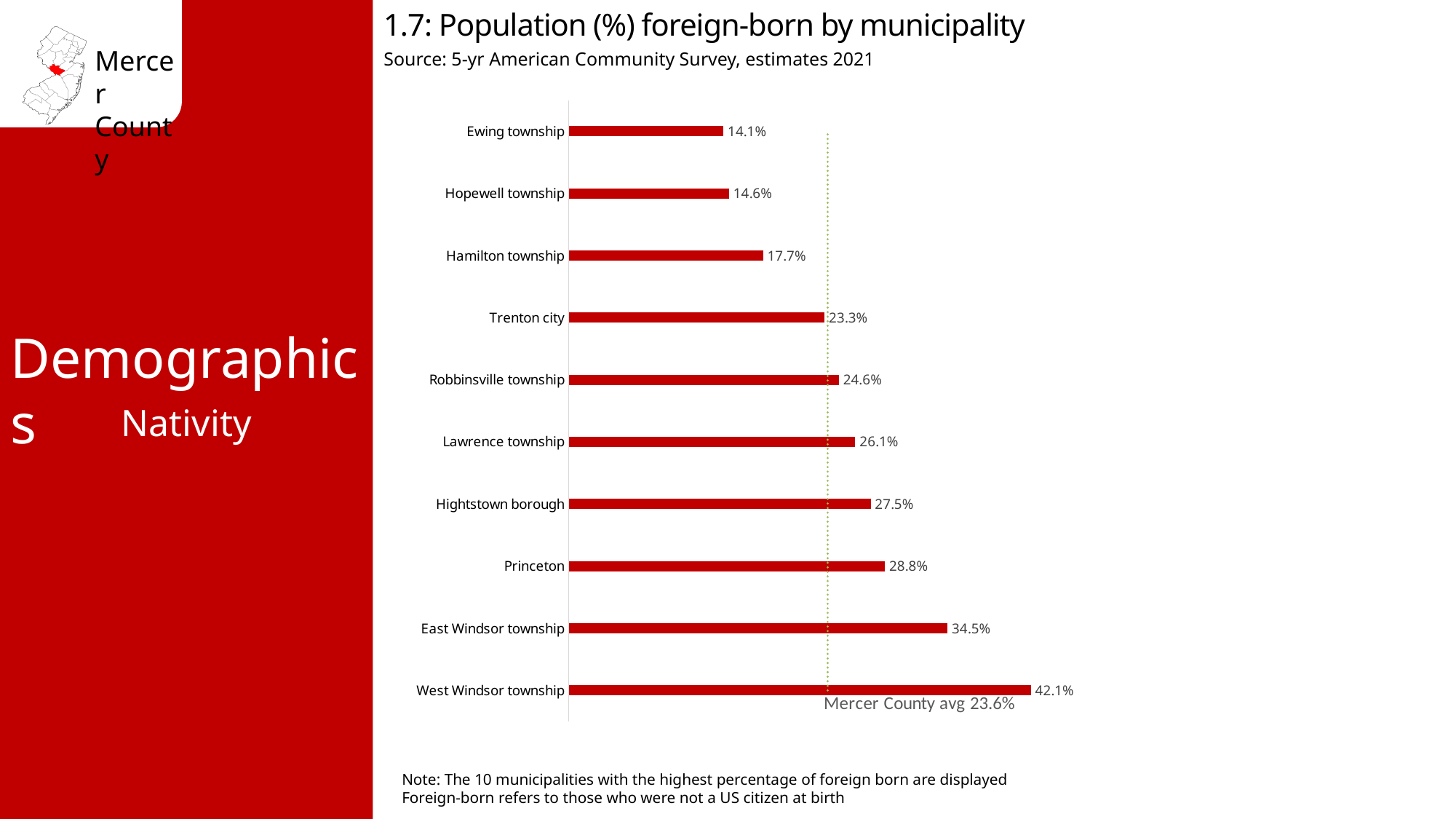
How many municipalities are shown in the chart? 10 What type of chart is shown on the slide? Bar chart Which has a higher foreign-born percentage, Lawrence township or Robbinsville township? Lawrence township What is the foreign-born population percentage for West Windsor township? 42.1% What is the difference in foreign-born percentage between West Windsor township and East Windsor township? 7.6% What is the difference in foreign-born percentage between Princeton and Hopewell township? 14.2% What is the foreign-born population percentage for Trenton city? 23.3% What is the Mercer County average foreign-born percentage marked by the dotted line? 23.6% What is the source of the data shown in the chart? 5-yr American Community Survey, estimates 2021 What is the foreign-born population percentage for Hamilton township? 17.7% Which municipality has the lowest foreign-born population percentage shown? Ewing township Which municipality has the highest foreign-born population percentage? West Windsor township